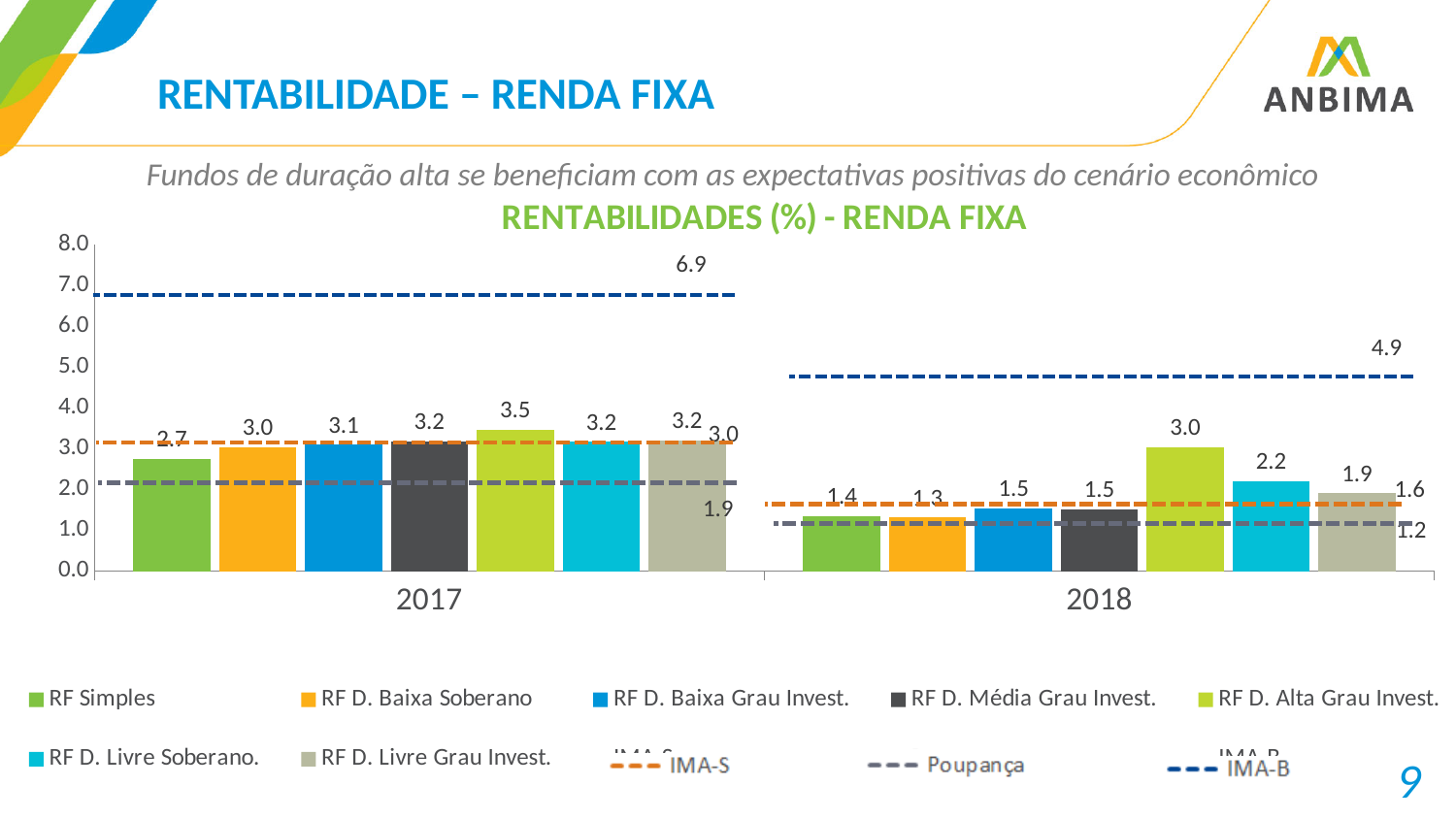
Which bar series has the highest value in 2018? RF D. Alta Grau Invest. Is the value for RF Simples larger in 2017 or in 2018? 2017 How many year categories are shown on the x axis? 2 What is the IMA-B value shown for 2018? 4.9 What kind of chart is used to show the fund returns? Bar chart Which bar series has the lowest value in 2018? RF D. Baixa Soberano What is the Poupança value shown for 2017? 1.9 What is the value for RF D. Alta Grau Invest. in 2017? 3.5 What is the difference between the IMA-B value in 2017 and in 2018? 2.0 How many entries does the legend list? 10 Does the value for RF D. Alta Grau Invest. rise or fall from 2017 to 2018? Fall What is the value for RF D. Livre Soberano. in 2018? 2.2